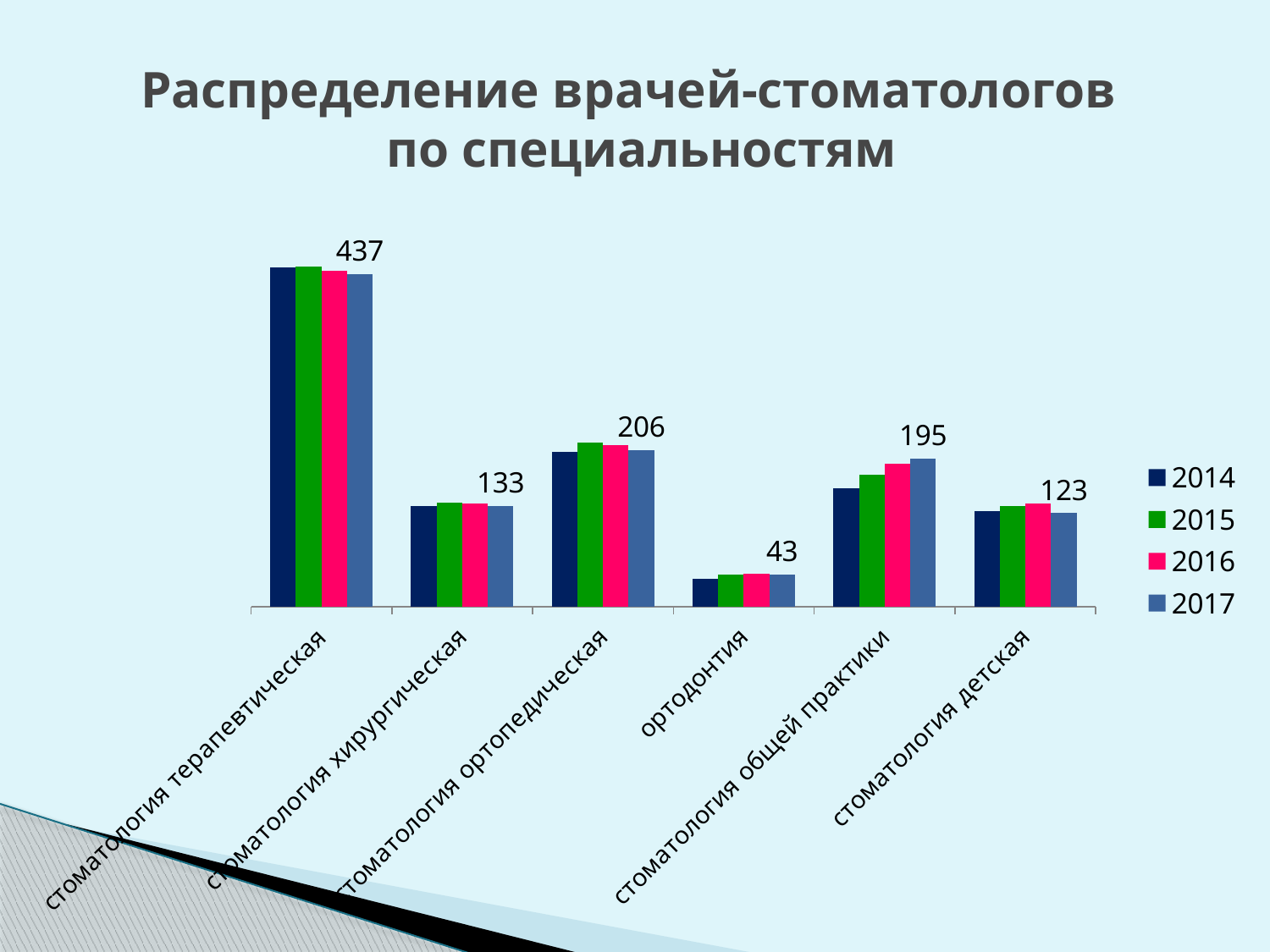
How many series does the legend list? 4 How many specialties are shown on the x axis? 6 In 2017, which is larger: стоматология общей практики or стоматология детская? стоматология общей практики What is the difference between the 2017 values for стоматология терапевтическая and стоматология детская? 314 What is the 2017 value for стоматология общей практики? 195 What kind of chart is shown on the slide? bar chart Which specialty has the highest number of dentists? стоматология терапевтическая What is the difference between the 2017 values for стоматология ортопедическая and стоматология хирургическая? 73 For стоматология общей практики, do the values rise or fall from 2014 to 2017? rise Which specialty has the lowest number of dentists? ортодонтия What is the 2017 value for стоматология терапевтическая? 437 What is the 2017 value for ортодонтия? 43